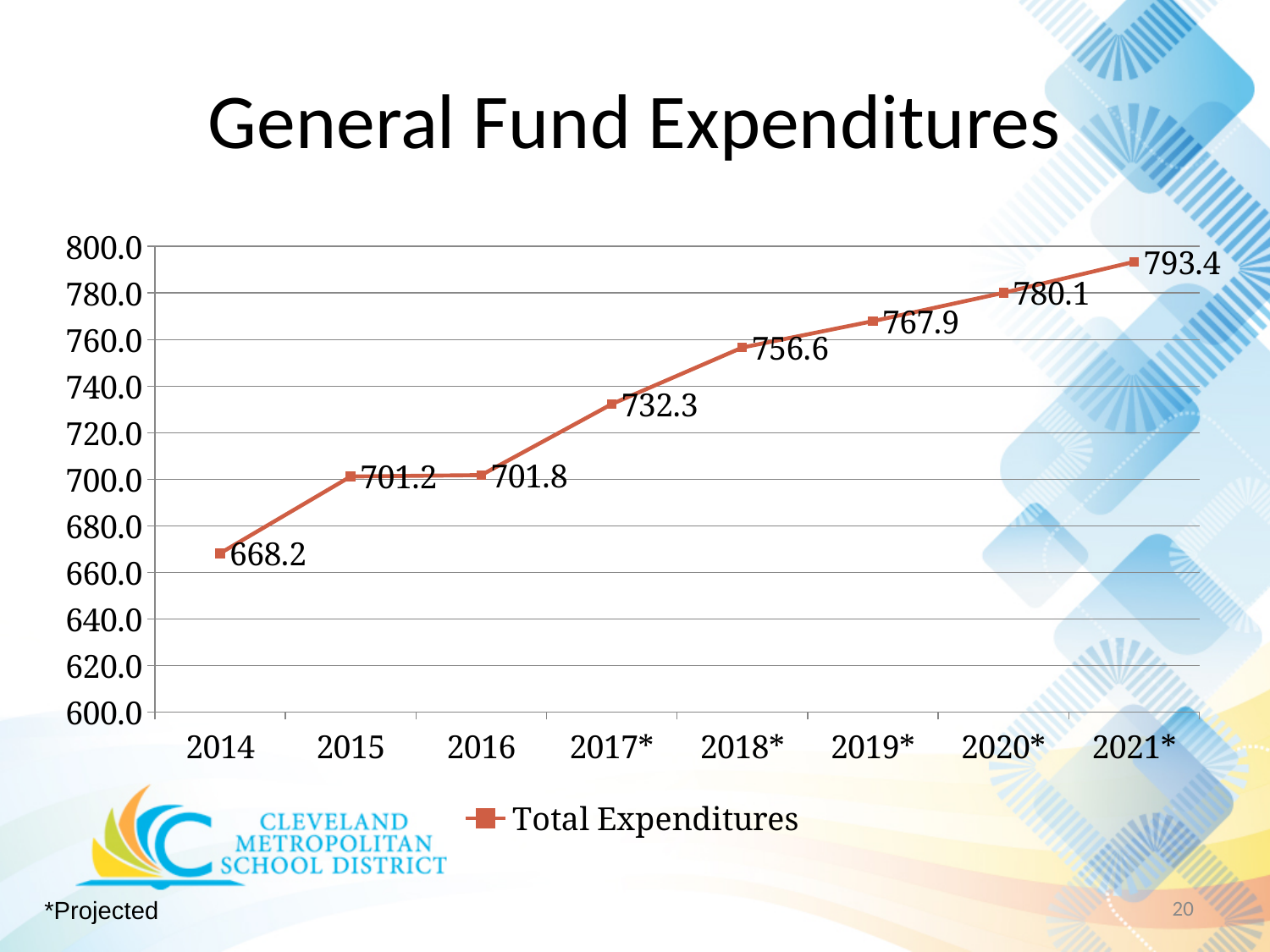
What is the value of Total Expenditures for 2018*? 756.6 Do Total Expenditures rise or fall from 2014 to 2021*? rise What is the value of Total Expenditures for 2014? 668.2 Which year has the lowest Total Expenditures? 2014 Is the value for 2020* greater or less than 760.0? greater Which year has the highest Total Expenditures? 2021* What is the difference between Total Expenditures in 2021* and 2014? 125.2 Which is larger, Total Expenditures in 2017* or in 2019*? 2019* What is the difference between Total Expenditures in 2016 and 2015? 0.6 How many years are plotted on the x axis? 8 What kind of chart is shown? line chart What is the value of Total Expenditures for 2021*? 793.4